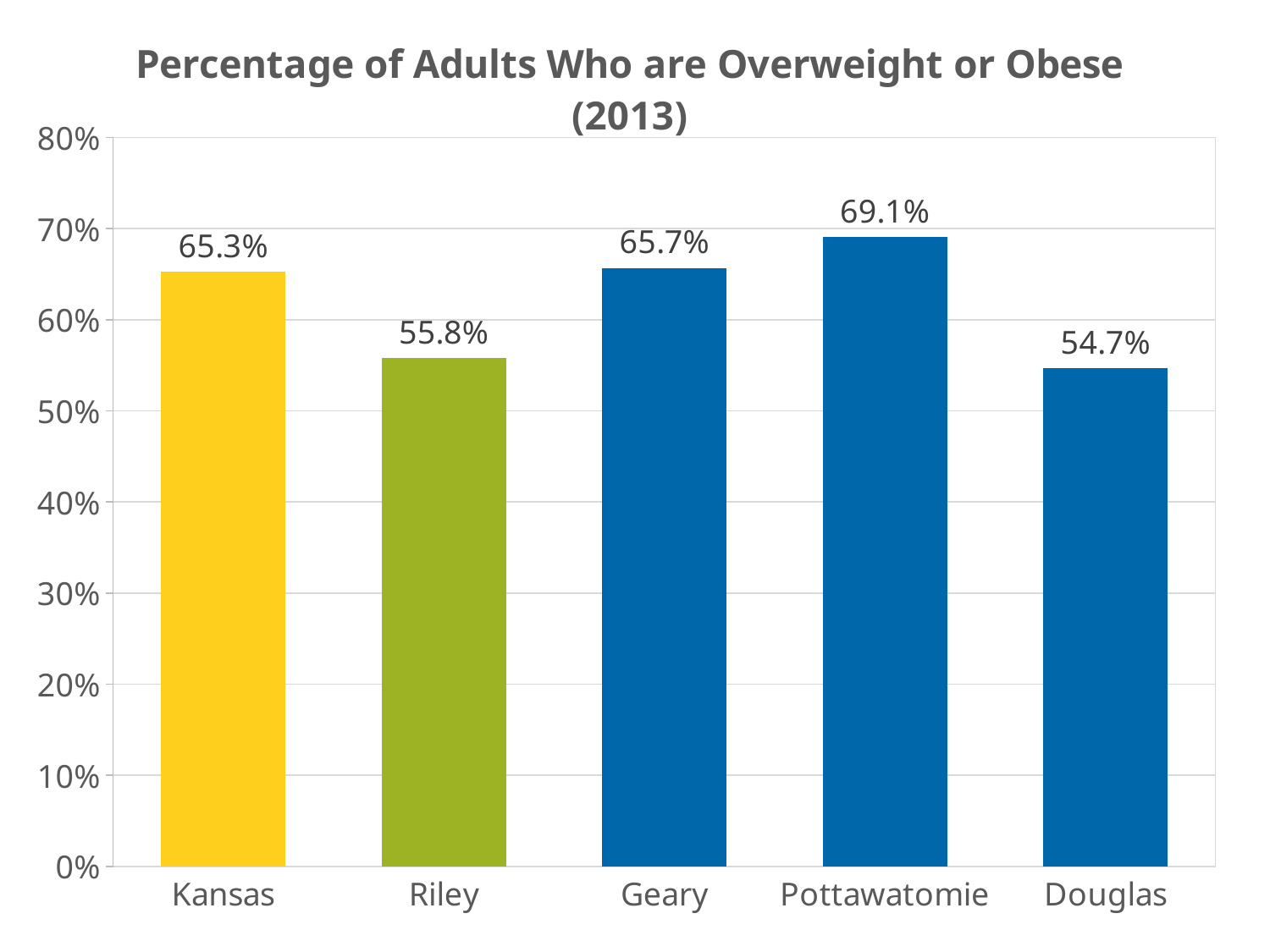
What is the difference between the values for Pottawatomie and Douglas? 14.4% What is the percentage of adults who are overweight or obese in Kansas? 65.3% Is the value for Douglas greater or less than 60%? less Which category has the lowest percentage? Douglas How many categories are shown on the chart? 5 What is the difference between the values for Geary and Kansas? 0.4% What kind of chart is shown on the slide? Bar chart Which has a larger value, Riley or Geary? Geary What is the value shown for Pottawatomie? 69.1% Which category has the highest percentage? Pottawatomie What is the title of the chart? Percentage of Adults Who are Overweight or Obese (2013) What is the value shown for Riley? 55.8%